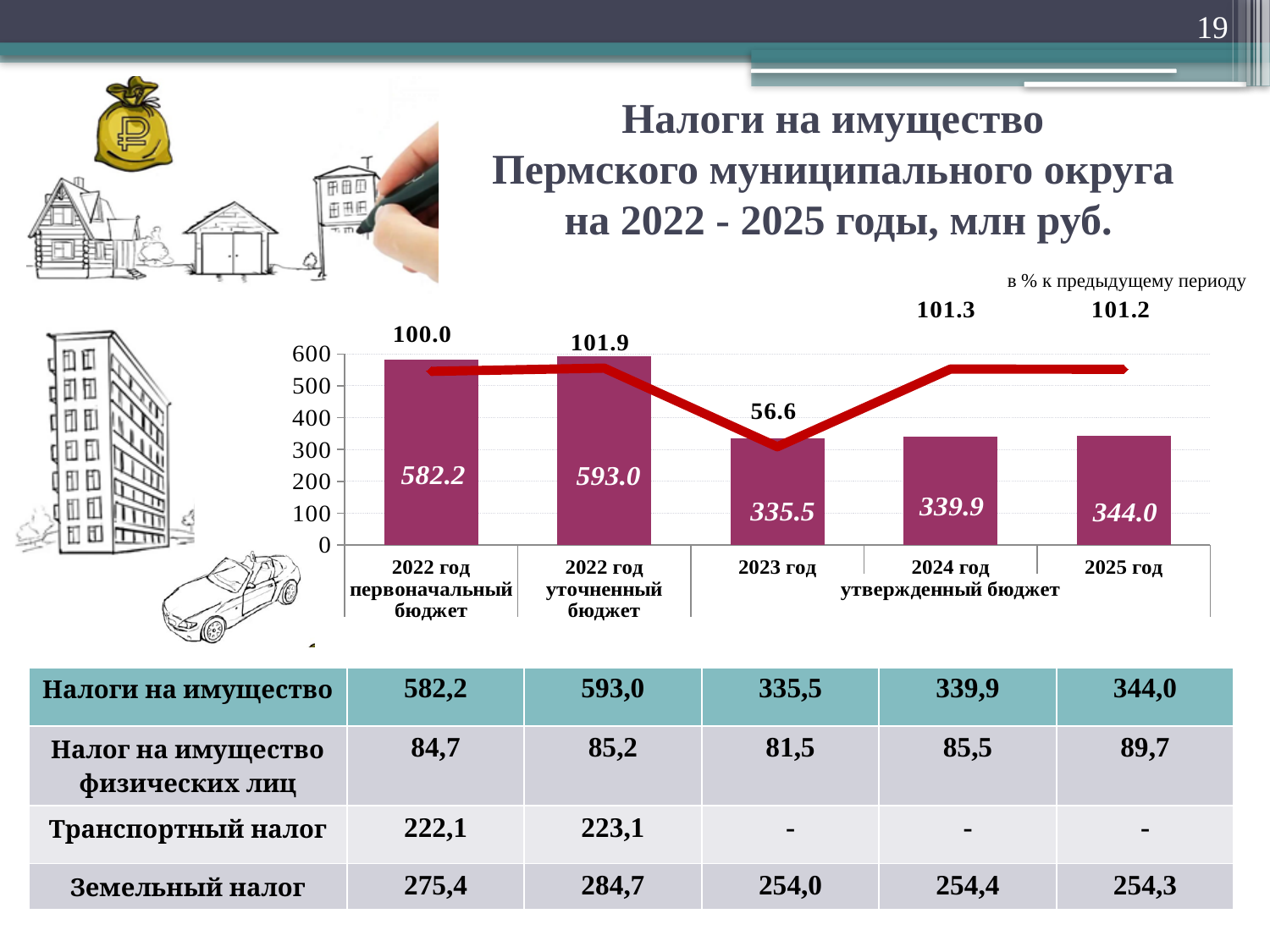
How many bars are plotted in the chart? 5 What is the value of the line (в % к предыдущему периоду) for 2025 год? 101.2 What kind of chart is shown on the slide? Combined bar and line chart What is the value of the bar for 2022 год уточненный бюджет? 593.0 What is the value of the bar for 2023 год? 335.5 Which category has the highest bar value? 2022 год уточненный бюджет What colour are the bars in the chart? Purple (magenta) Which is larger, the bar value for 2024 год or for 2025 год? 2025 год Which category has the lowest bar value? 2023 год What is the value of the line (в % к предыдущему периоду) for 2023 год? 56.6 What is the difference between the bar values for 2022 год уточненный бюджет and 2022 год первоначальный бюджет? 10.8 Do the bar values rise or fall from 2023 год to 2025 год? Rise